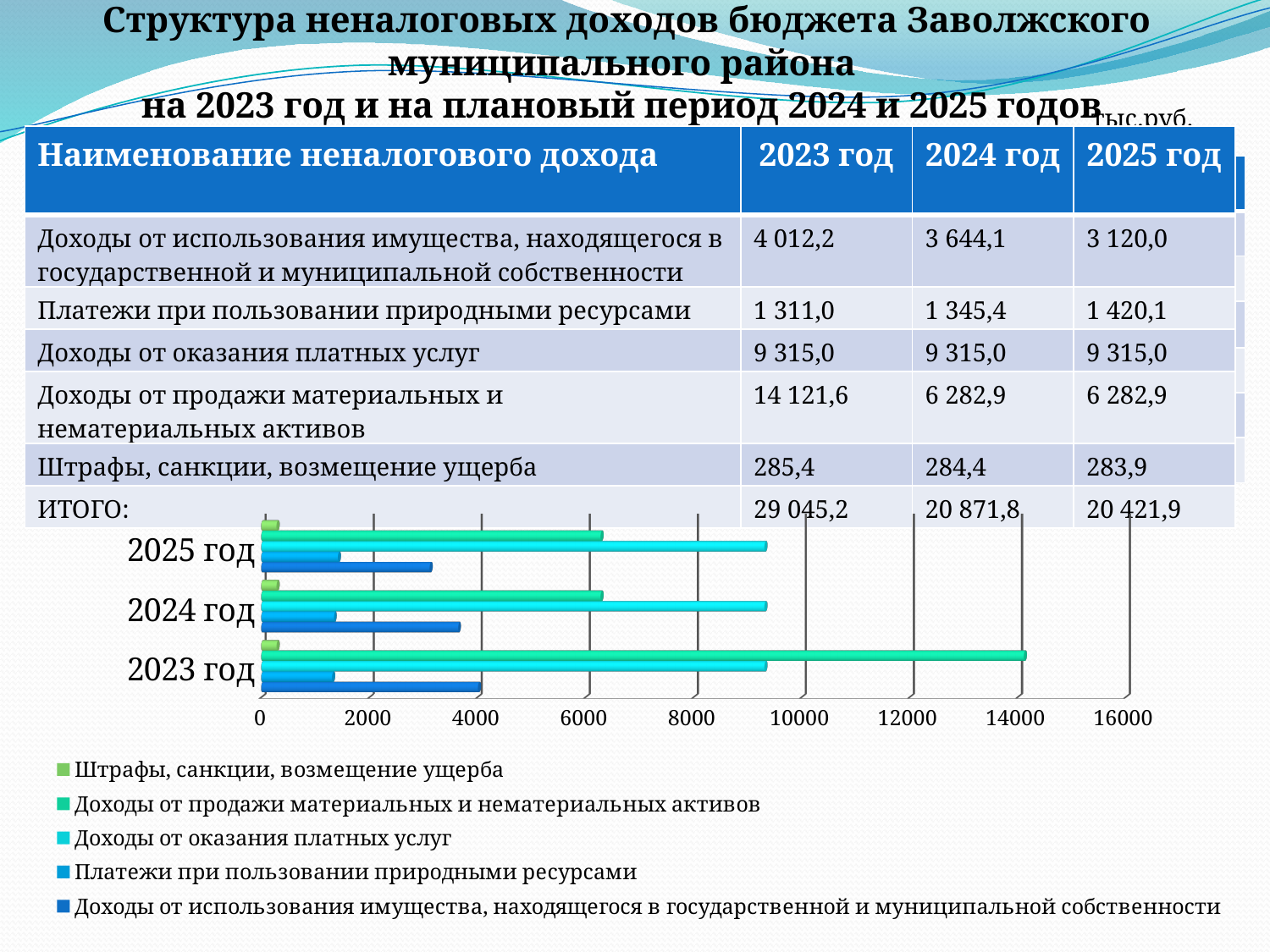
What is the highest tick value shown on the chart's horizontal axis? 16000 What type of chart is shown on the slide? bar chart Is the value for Доходы от оказания платных услуг in 2024 год greater or less than 10000? less Is the value for Доходы от продажи материальных и нематериальных активов in 2023 год greater or less than 12000? greater How many year categories does the chart show? 3 How many series does the chart legend list? 5 Does the bar for Доходы от использования имущества, находящегося в государственной и муниципальной собственности rise or fall from 2023 год to 2025 год? fall Which series has the longest bar for 2023 год? Доходы от продажи материальных и нематериальных активов Is the value for Доходы от использования имущества, находящегося в государственной и муниципальной собственности in 2025 год greater or less than 4000? less Which series has the shortest bar in each year? Штрафы, санкции, возмещение ущерба In 2024 год, which is larger: Доходы от продажи материальных и нематериальных активов or Доходы от оказания платных услуг? Доходы от оказания платных услуг